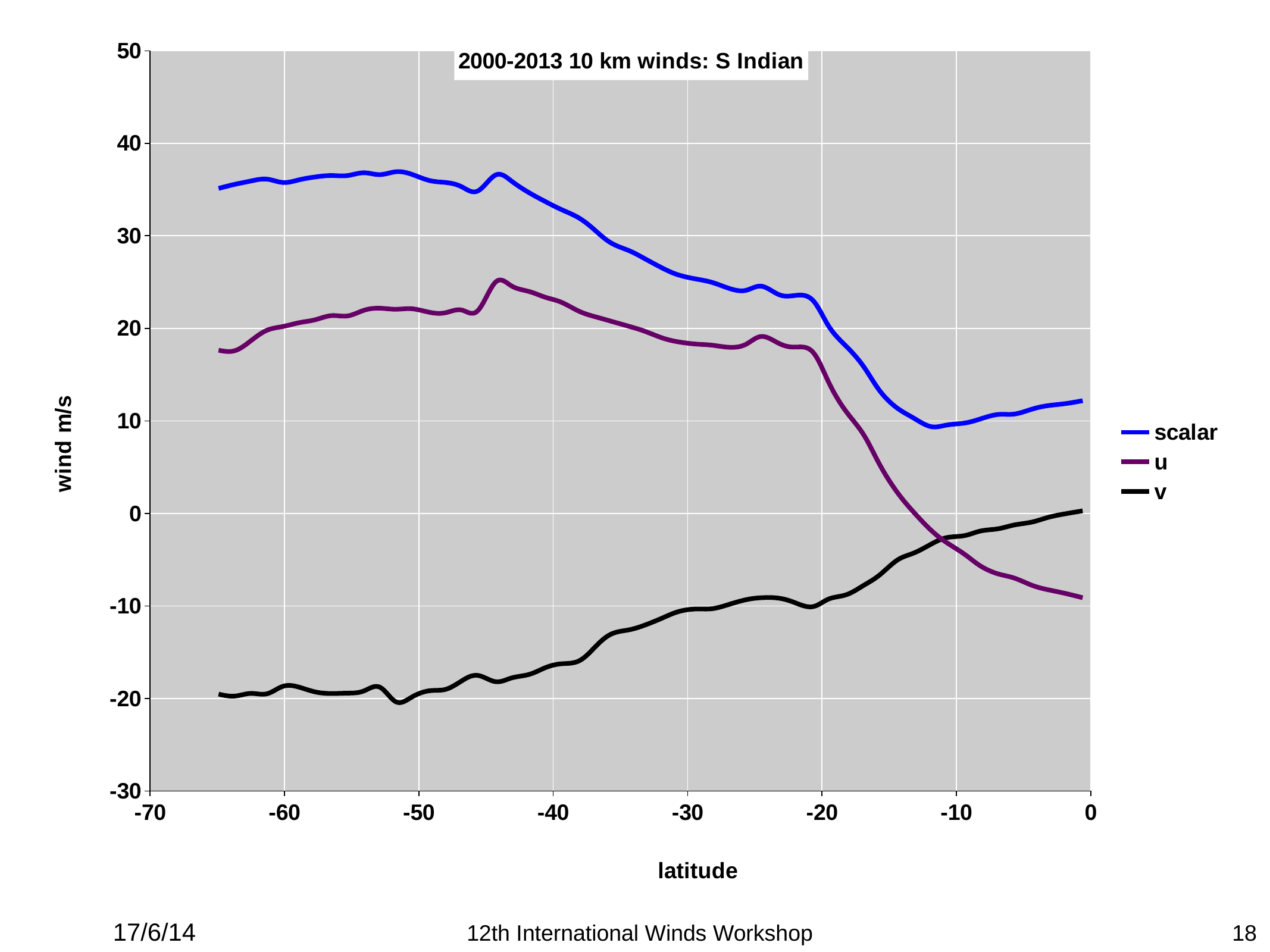
Does the v series rise or fall as latitude goes from -60 to 0? rise Is the value of the u series at latitude -40 greater or less than 20? greater How many series does the legend list? 3 Is the value of the v series at latitude -60 greater or less than -10? less What is the title of the chart? 2000-2013 10 km winds: S Indian Is the value of the scalar series at latitude -60 greater or less than 30? greater What is the label on the vertical axis of the chart? wind m/s Which series has the lowest value at latitude -50? v At latitude -5, which series has the larger value, u or v? v What kind of chart is shown on the slide? line chart At latitude -30, which series has the larger value, scalar or u? scalar